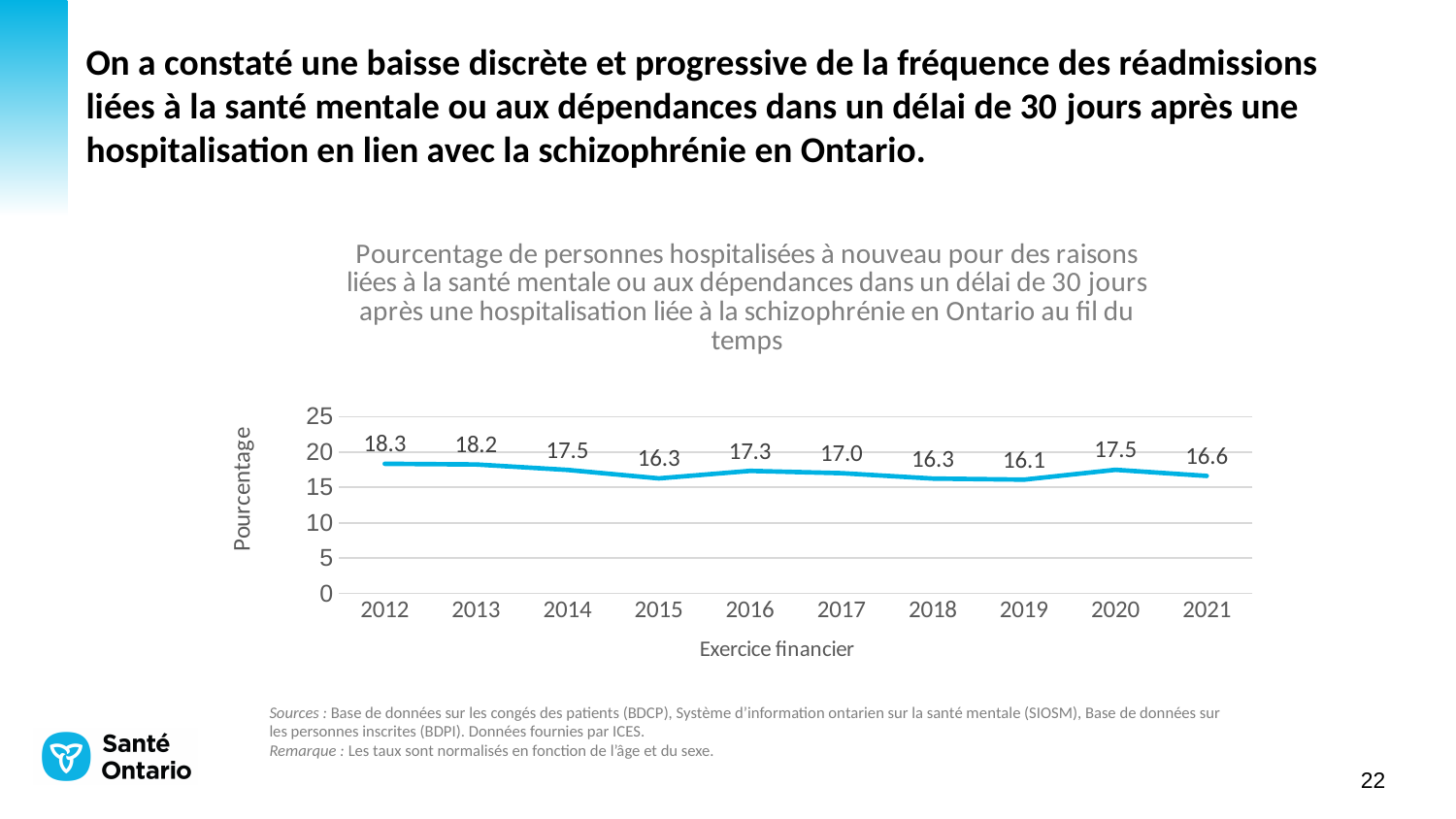
How many years are plotted on the x axis? 10 What is the value for 2021? 16.6 What is the value for 2012? 18.3 What is the value for 2016? 17.3 Which year has the lowest value? 2019 What is the difference between the values for 2012 and 2021? 1.7 What is the label of the y axis? Pourcentage Which year has the highest value? 2012 Do the values generally rise or fall from 2012 to 2021? fall What kind of chart is shown? line chart Is the value for 2015 greater or less than 20? less Which is larger, the value for 2013 or the value for 2014? 2013